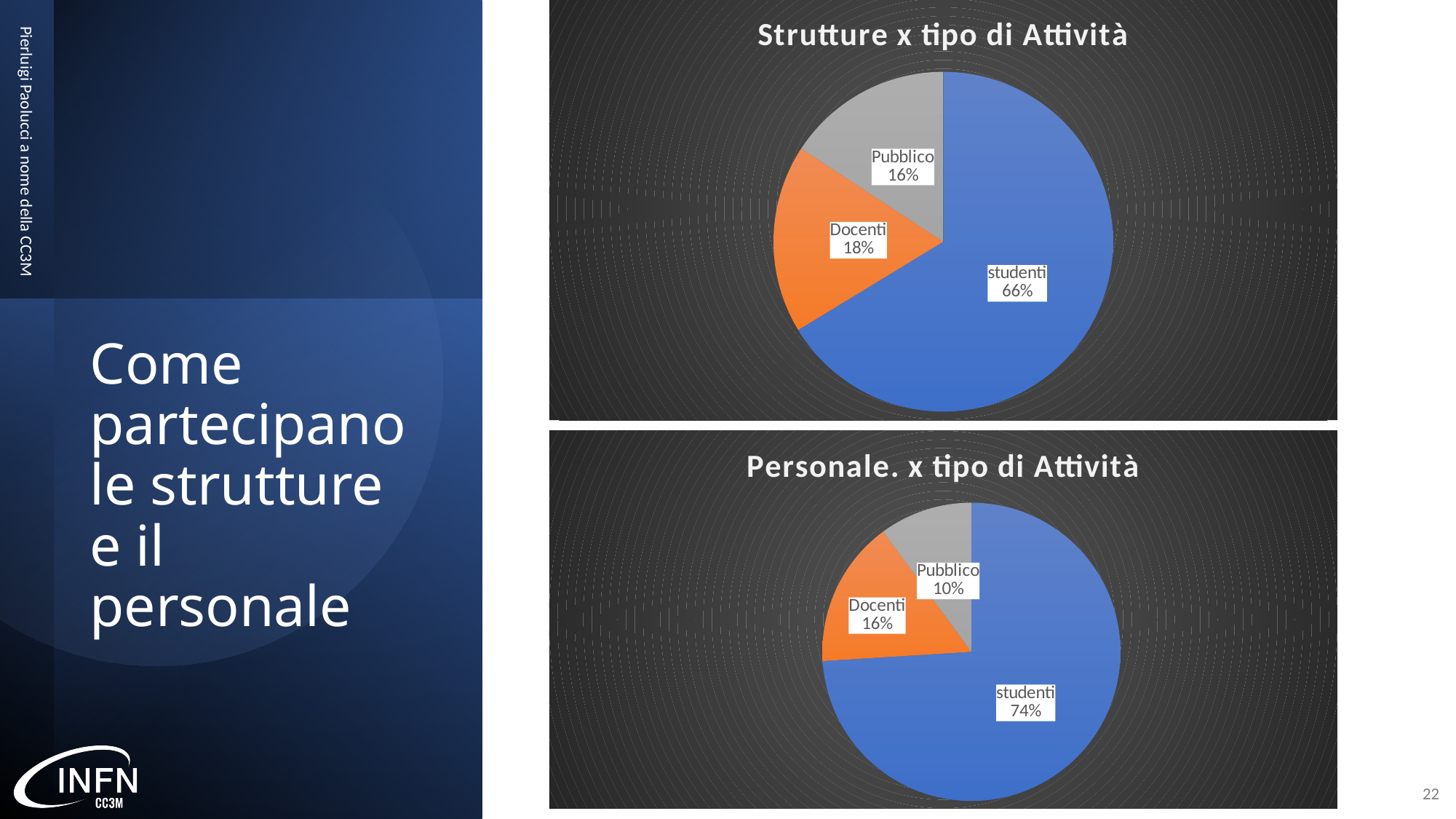
In the 'Strutture x tipo di Attività' chart, what share does studenti have? 66% What is the title of the bottom chart on the slide? Personale. x tipo di Attività In the 'Strutture x tipo di Attività' chart, what share does Docenti have? 18% In the 'Strutture x tipo di Attività' chart, which is larger, Docenti or Pubblico? Docenti In the 'Personale. x tipo di Attività' chart, what share does studenti have? 74% In the 'Strutture x tipo di Attività' chart, what share does Pubblico have? 16% In the 'Strutture x tipo di Attività' chart, which category has the largest slice? studenti What type of chart is the top chart on the slide? Pie chart In the 'Personale. x tipo di Attività' chart, what share does Pubblico have? 10% How many slices does the 'Personale. x tipo di Attività' chart have? 3 In the 'Personale. x tipo di Attività' chart, what is the difference between the studenti share and the Docenti share? 58% In the 'Personale. x tipo di Attività' chart, which category has the smallest slice? Pubblico